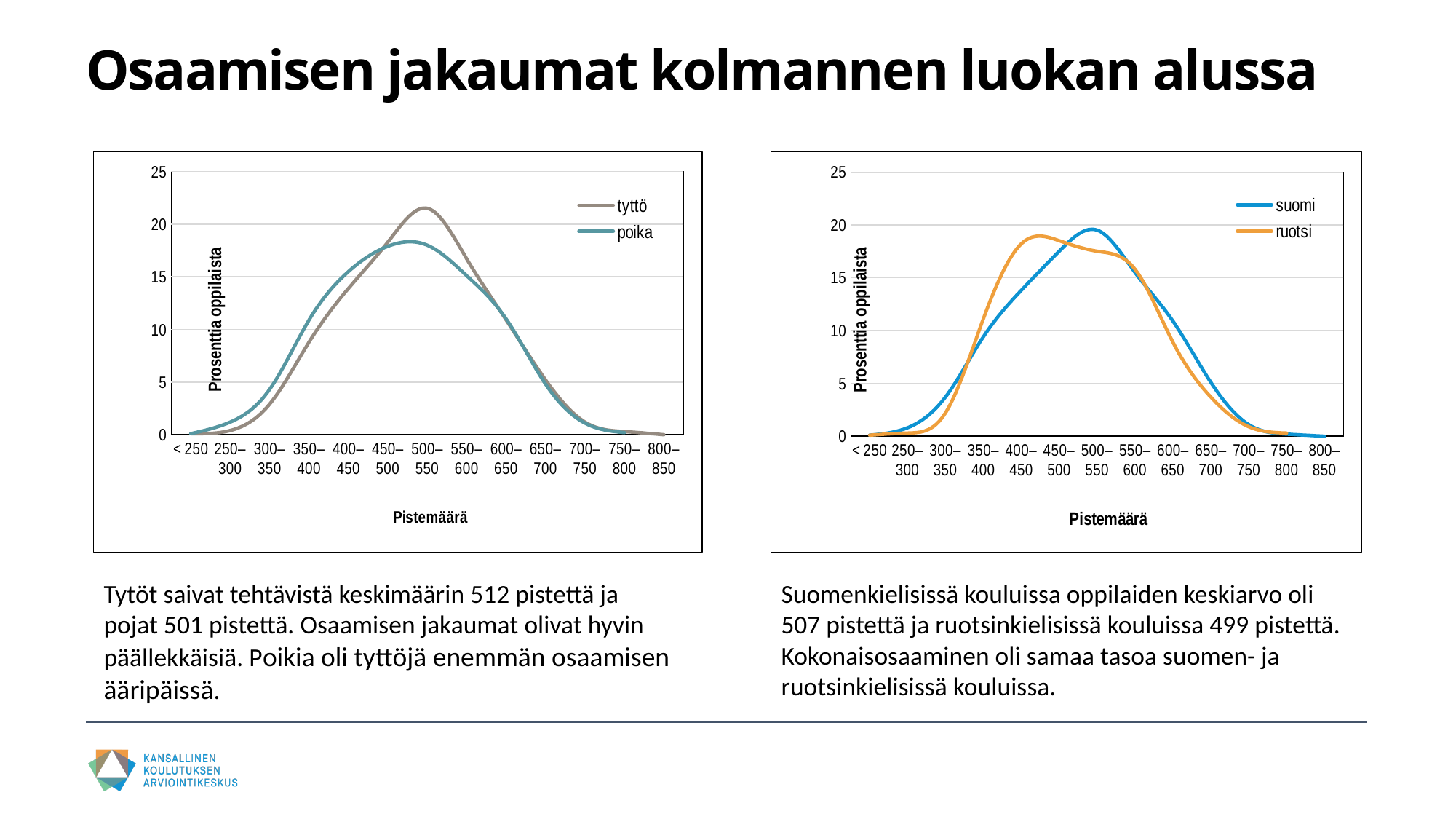
In the left chart (tyttö/poika), which series has the higher value at 500–550, tyttö or poika? tyttö In the left chart (tyttö/poika), is the value for tyttö at 500–550 greater or less than 20? greater In the right chart (suomi/ruotsi), is the value for suomi at 650–700 greater or less than 10? less In the right chart (suomi/ruotsi), which series has the higher value at 450–500, suomi or ruotsi? ruotsi How many score categories are shown on the x axis of the left chart (tyttö/poika)? 13 How many series does the legend of the right chart (suomi/ruotsi) list? 2 In the left chart (tyttö/poika), is the value for poika at 500–550 greater or less than 20? less In the left chart (tyttö/poika), which series has the higher value at 400–450, tyttö or poika? poika What is the y-axis title of the left chart (tyttö/poika)? Prosenttia oppilaista What kind of chart is the left chart (tyttö/poika)? line chart